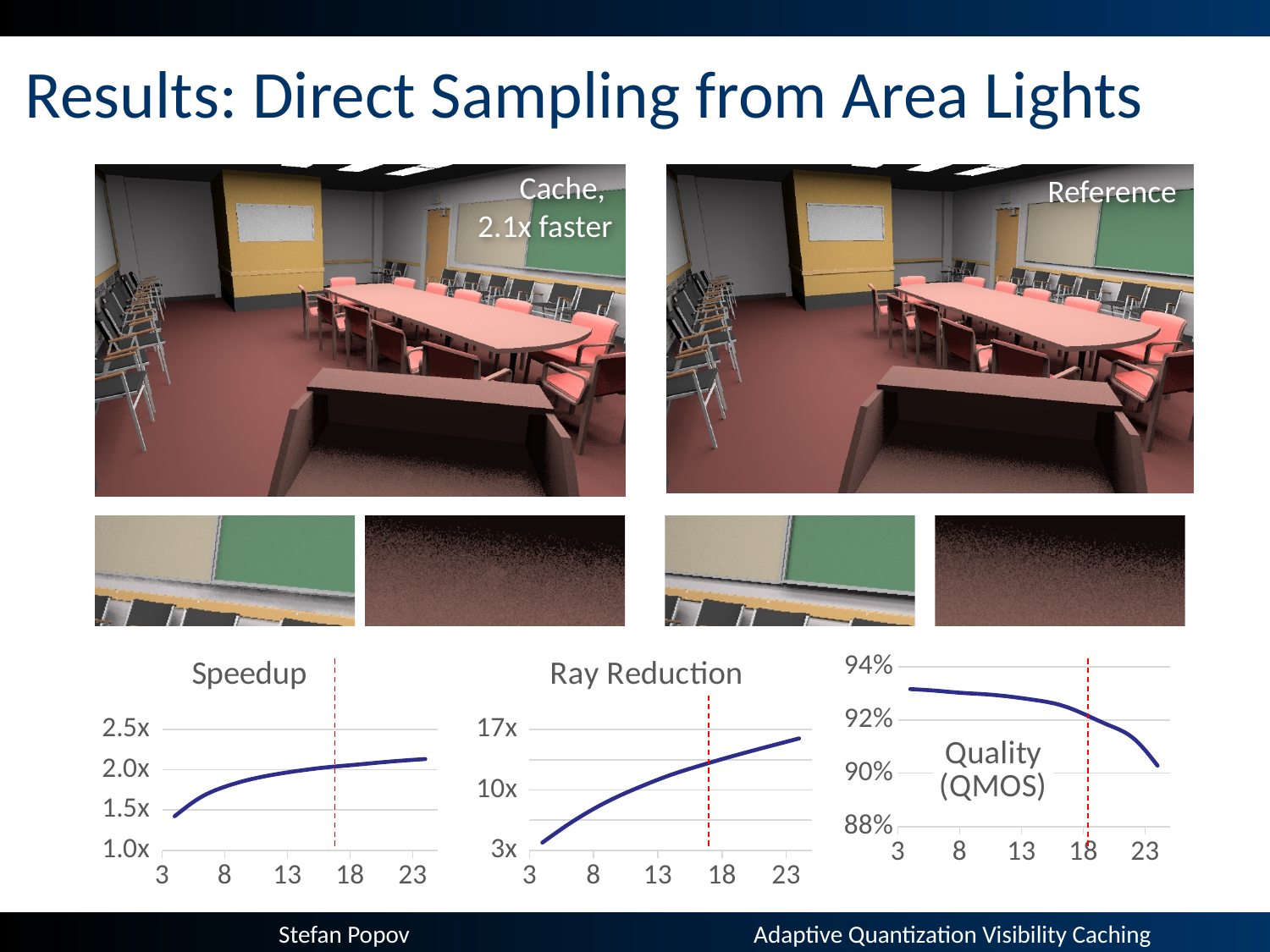
In the Ray Reduction chart, do the values rise or fall along the x axis? rise What kind of chart is the Speedup chart? line chart In the Quality (QMOS) chart, is the value at x = 23 greater or less than 92%? less In the Quality (QMOS) chart, do the values rise or fall along the x axis? fall How many charts are shown at the bottom of the slide? 3 In the Speedup chart, do the values rise or fall as the x axis increases from 3 to 23? rise In the Quality (QMOS) chart, is the value at x = 3 greater or less than 92%? greater What kind of chart is the Ray Reduction chart? line chart In the Speedup chart, is the value at x = 3 greater or less than 1.5x? less What is the title of the rightmost chart on the slide? Quality (QMOS)